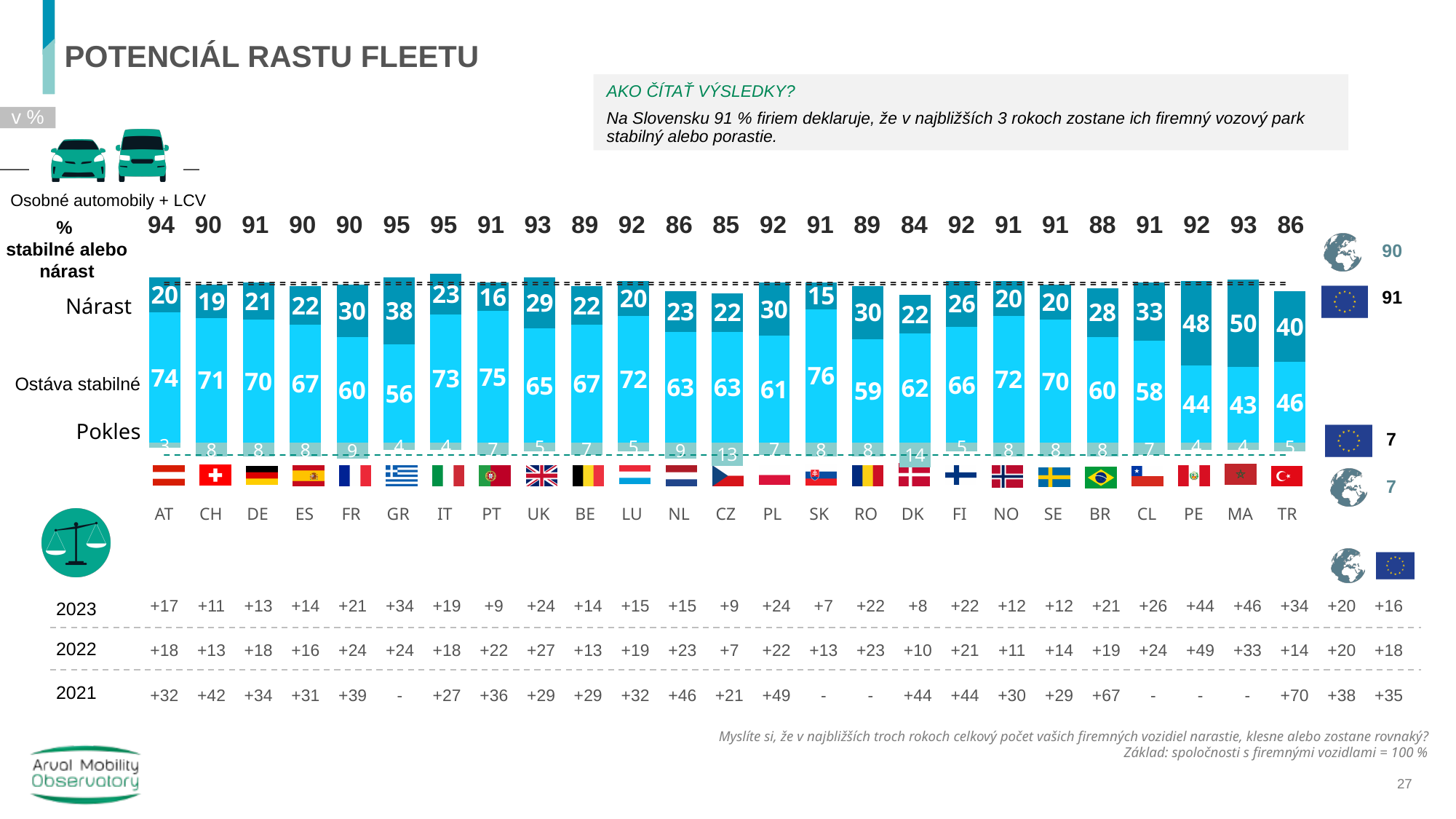
Which has the larger Nárast value, FR or PT? FR What is the Pokles value for CZ? 13 Which country has the highest Pokles value? DK What is the '% stabilné alebo nárast' value shown above the bar for DK? 84 What type of chart is used to show Nárast, Ostáva stabilné and Pokles by country? Stacked bar chart Which country has the lowest Ostáva stabilné value? MA What is the difference between the Nárast values for MA and SK? 35 Which country has the lowest Nárast value? SK What is the Ostáva stabilné value for NL? 63 How many countries are shown in the bar chart? 25 Which country has the highest Nárast value? MA What is the Nárast value for GR? 38